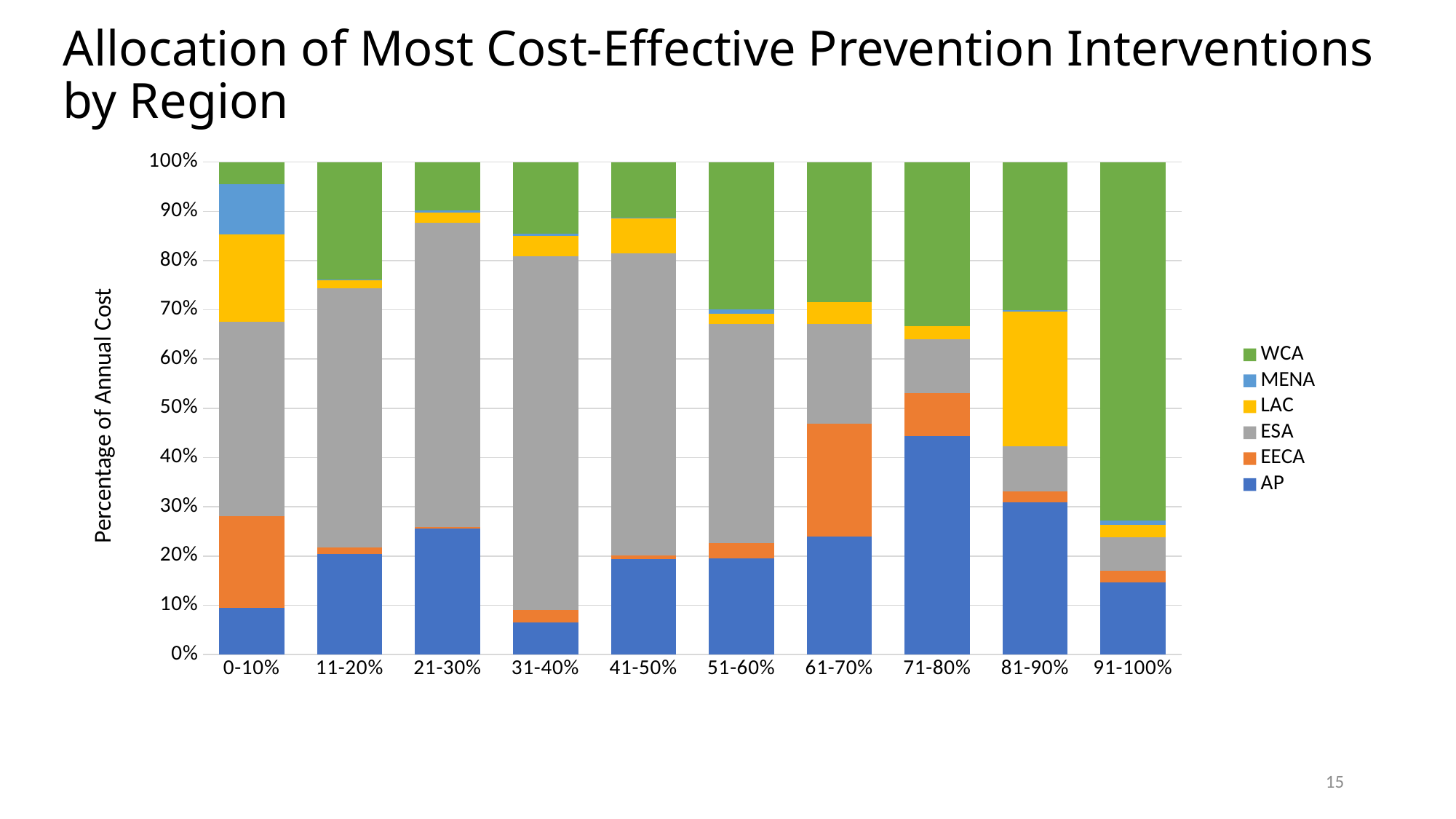
Which category has the largest WCA segment? 91-100% Which category has the largest ESA segment? 31-40% What is the label of the vertical axis? Percentage of Annual Cost Is the AP value for 71-80% greater or less than 40%? greater Which category has the largest LAC segment? 81-90% How many categories are shown along the x axis? 10 How many series does the legend list? 6 Which category has the smallest AP segment? 31-40% Which is larger, the AP segment for 71-80% or the AP segment for 0-10%? 71-80% Is the AP value for 31-40% greater or less than 10%? less What kind of chart is shown on the slide? Stacked bar chart